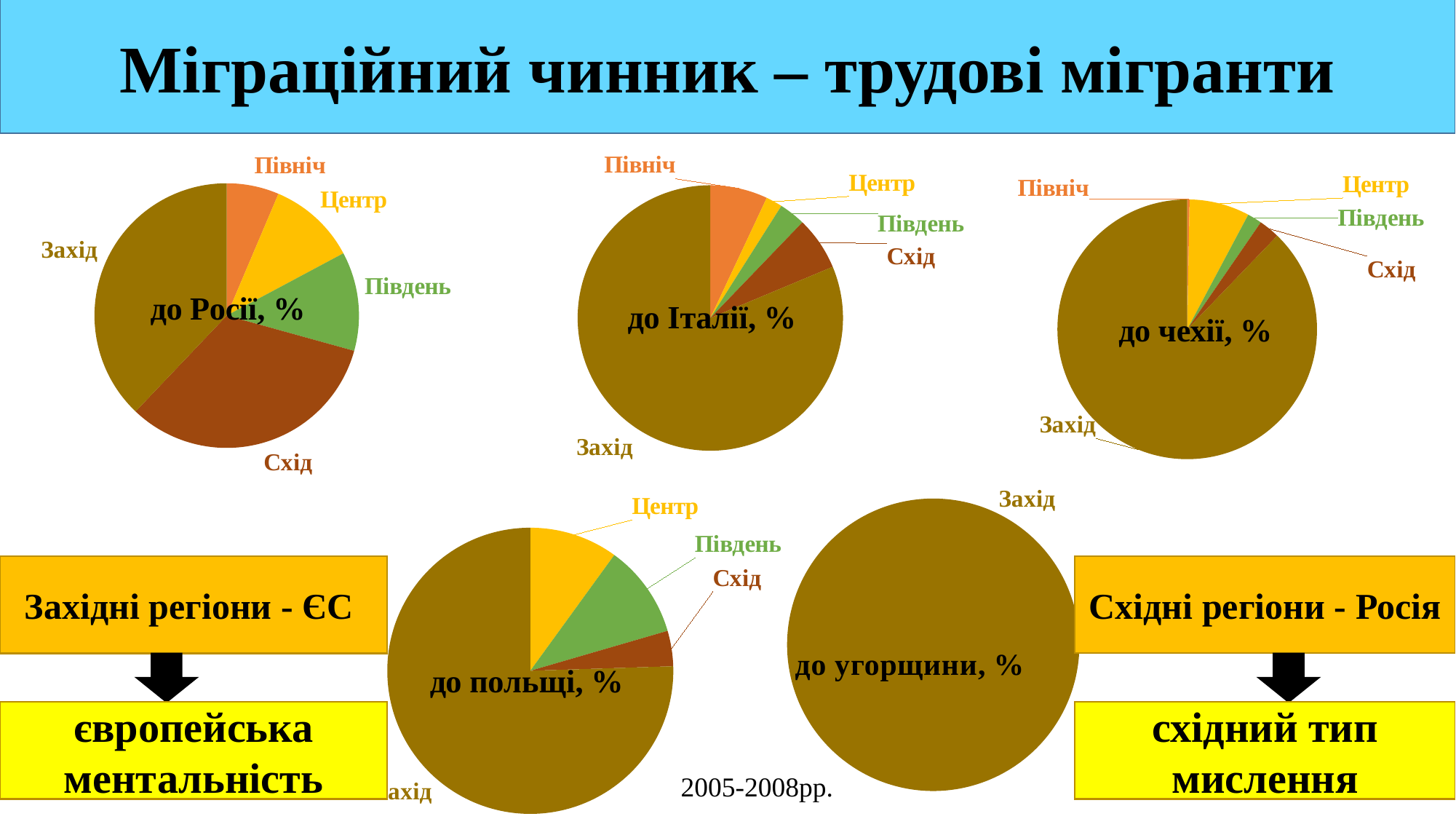
How many slices does the "до польщі, %" pie chart have? 4 How many pie charts are shown on the slide? 5 In the "до чехії, %" pie chart, which region has the smallest slice? Північ In the "до Росії, %" pie chart, which region has the smallest slice? Північ In the "до угорщини, %" pie chart, which region makes up the whole pie? Захід In the "до польщі, %" pie chart, which slice is larger: Центр or Схід? Центр In the "до Італії, %" pie chart, which slice is larger: Північ or Центр? Північ How many slices does the "до Росії, %" pie chart have? 5 In the "до Італії, %" pie chart, which region has the largest slice? Захід In the "до Росії, %" pie chart, which slice is larger: Схід or Південь? Схід What kind of chart is "до Росії, %"? pie chart In the "до Росії, %" pie chart, which region has the largest slice? Захід